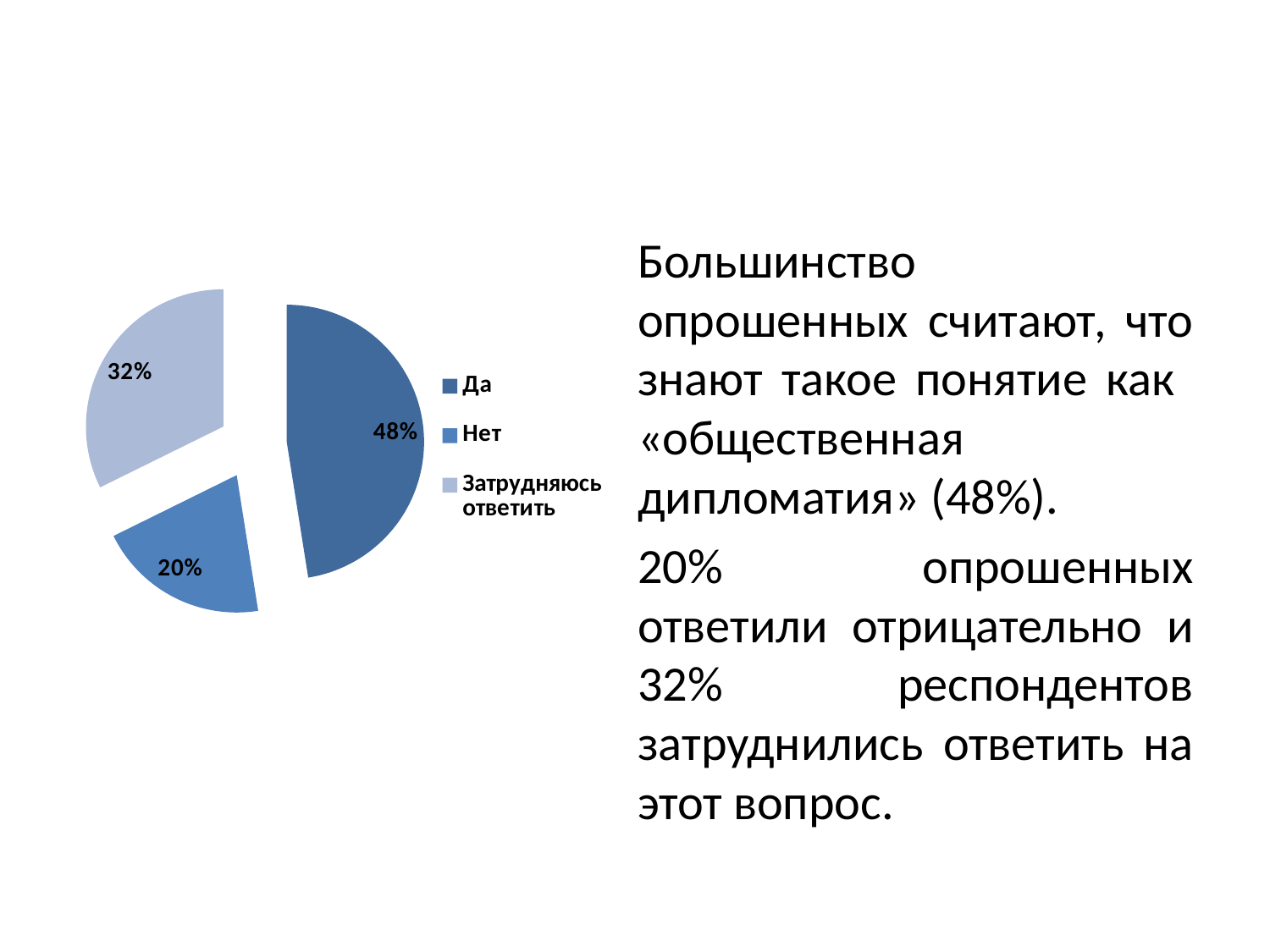
Which legend entry is shown in the lightest shade of blue? Затрудняюсь ответить Which category has the smallest slice of the pie? Нет How many slices does the pie chart have? 3 What percentage of the pie is labelled "Затрудняюсь ответить"? 32% What percentage of the pie is labelled "Да"? 48% What is the difference in percentage points between the "Да" and "Нет" slices? 28 What percentage of the pie is labelled "Нет"? 20% Which category has the largest slice of the pie? Да What is the difference in percentage points between the "Затрудняюсь ответить" and "Нет" slices? 12 What kind of chart is shown on the slide? pie chart How many entries does the legend list? 3 Which slice is larger, "Нет" or "Затрудняюсь ответить"? Затрудняюсь ответить